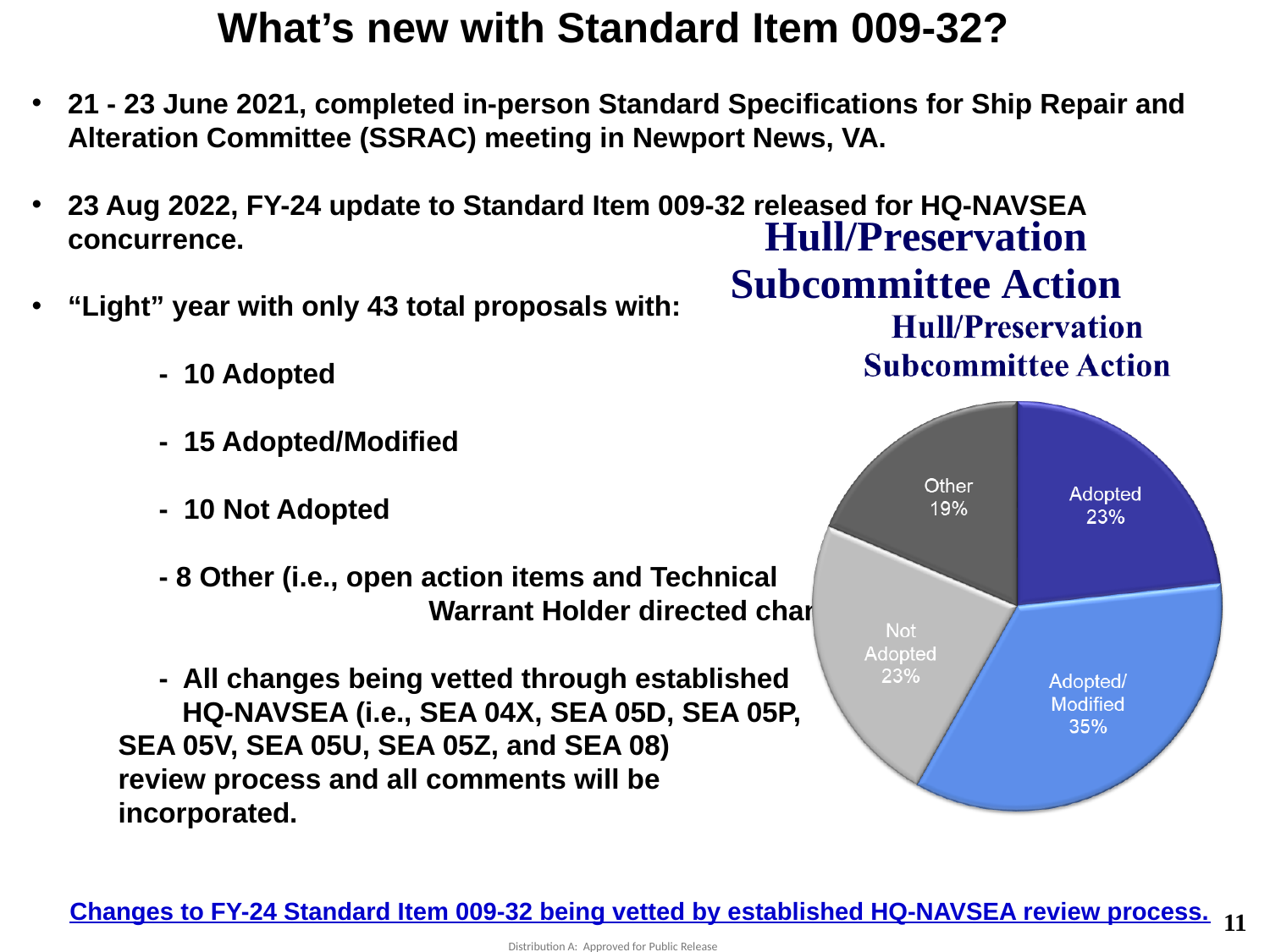
What is the difference in percentage points between the Adopted/Modified slice and the Other slice? 16 How many slices does the pie chart have? 4 What percentage is shown for the Adopted slice? 23% Which is larger, the Adopted/Modified slice or the Other slice? Adopted/Modified What percentage is shown for the Not Adopted slice? 23% Which slice of the pie chart is the smallest? Other What is the difference in percentage points between the Adopted/Modified slice and the Adopted slice? 12 What share of the pie does the Other slice represent? 19% What is the title of the pie chart? Hull/Preservation Subcommittee Action What share of the pie does the Adopted/Modified slice represent? 35% Which slice of the pie chart is the largest? Adopted/Modified What kind of chart is shown on the slide? Pie chart